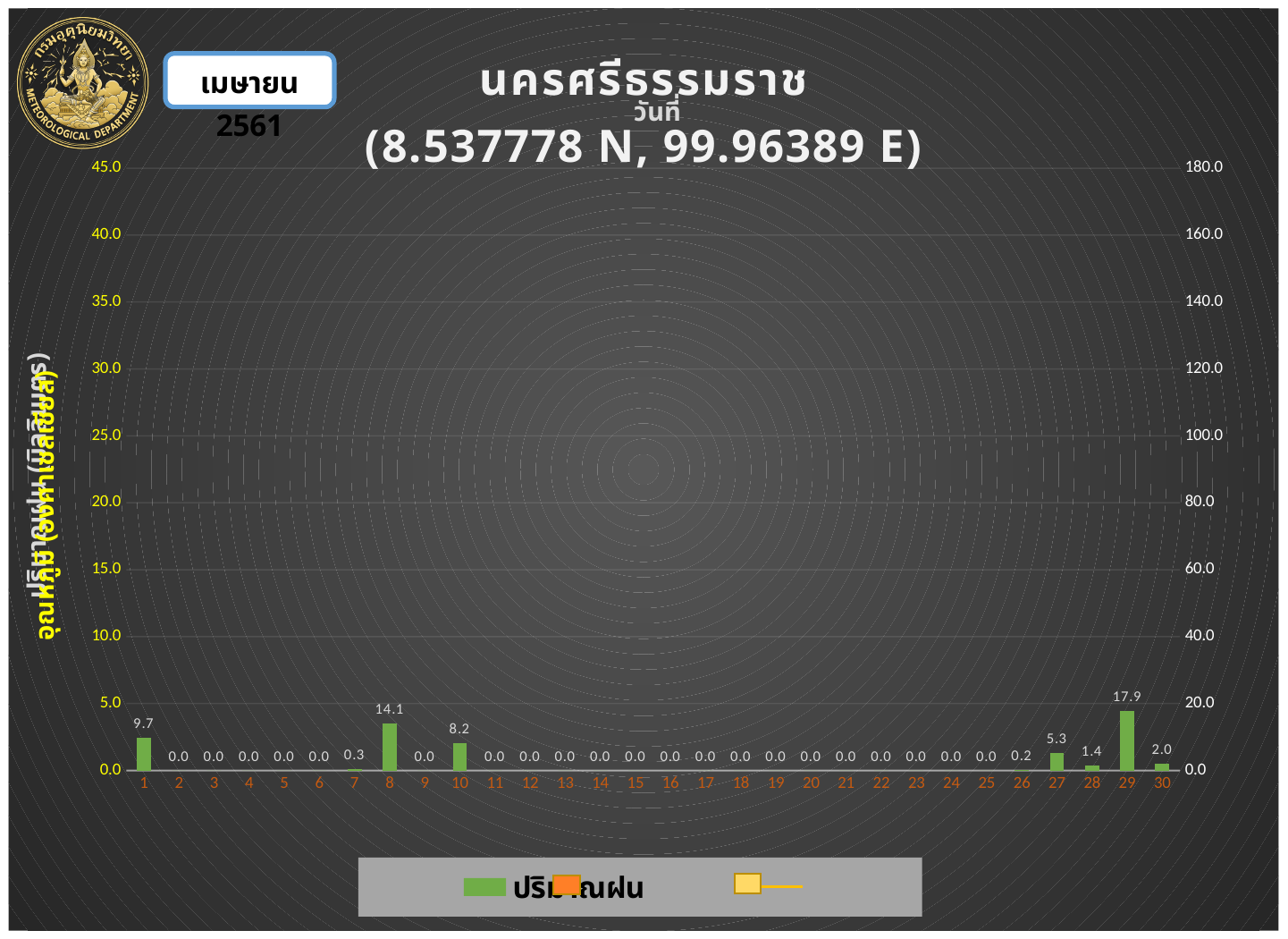
What kind of chart is used to show the rainfall values? bar chart How many days are shown on the x axis? 30 What is the highest value shown on the right-hand vertical axis? 180.0 What is the rainfall value shown for day 29? 17.9 What are the coordinates shown in the chart title? 8.537778 N, 99.96389 E What is the rainfall value shown for day 8? 14.1 Which day has the highest rainfall value? 29 What is the rainfall value shown for day 1? 9.7 What is the rainfall value shown for day 27? 5.3 Which is larger, the rainfall value for day 1 or for day 10? day 1 What is the difference between the rainfall values for day 10 and day 27? 2.9 What is the difference between the rainfall values for day 29 and day 8? 3.8